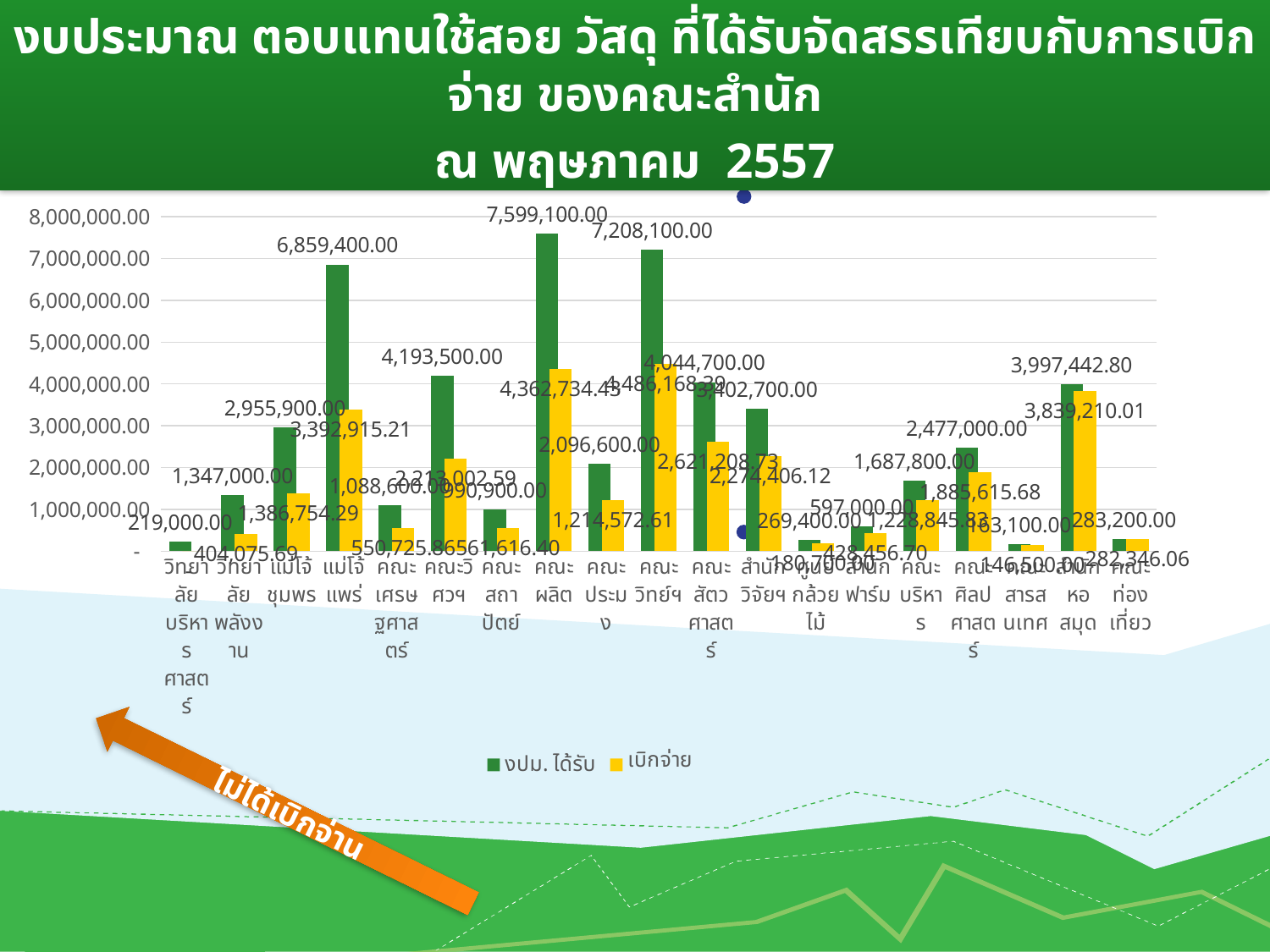
What is the งปม. ได้รับ value for แม่โจ้แพร่? 6,859,400.00 What is the งปม. ได้รับ value for คณะวิทย์ฯ? 7,208,100.00 What is the difference between the งปม. ได้รับ values of คณะผลิต and คณะวิทย์ฯ? 391,000.00 What are the two series named in the legend? งปม. ได้รับ and เบิกจ่าย Which is larger, the งปม. ได้รับ value for คณะวิศวฯ or for คณะศิลปศาสตร์? คณะวิศวฯ Is the งปม. ได้รับ value for แม่โจ้แพร่ greater or less than 6,000,000.00? greater How many series does the legend list? 2 What kind of chart is shown on the slide? Bar chart Which category has the highest งปม. ได้รับ value? คณะผลิต How many faculties/offices (categories) are shown on the x axis? 19 What is the เบิกจ่าย value for สำนักหอสมุด? 3,839,210.01 What is the งปม. ได้รับ value for คณะผลิต? 7,599,100.00